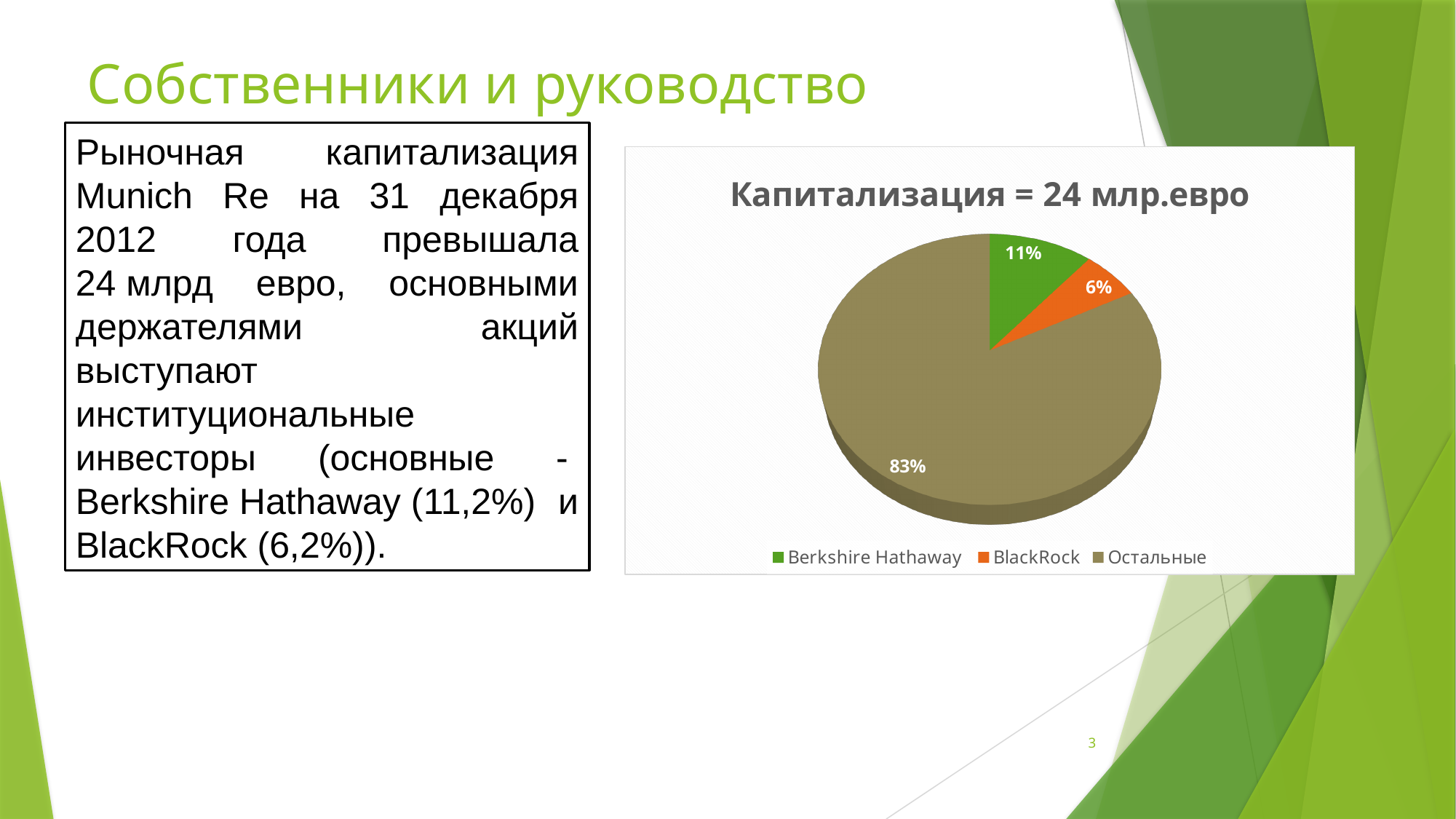
What is the difference in percentage points between the Berkshire Hathaway and BlackRock slices? 5% What colour is the BlackRock slice in the legend? orange What is the difference in percentage points between the Остальные and Berkshire Hathaway slices? 72% Which slice is larger, Berkshire Hathaway or BlackRock? Berkshire Hathaway What share of the pie does Berkshire Hathaway hold? 11% What is the title of the chart? Капитализация = 24 млр.евро Which category has the smallest slice of the pie? BlackRock What kind of chart is shown on the slide? pie chart How many slices does the pie chart have? 3 What share of the pie does Остальные hold? 83% Which category has the largest slice of the pie? Остальные What share of the pie does BlackRock hold? 6%